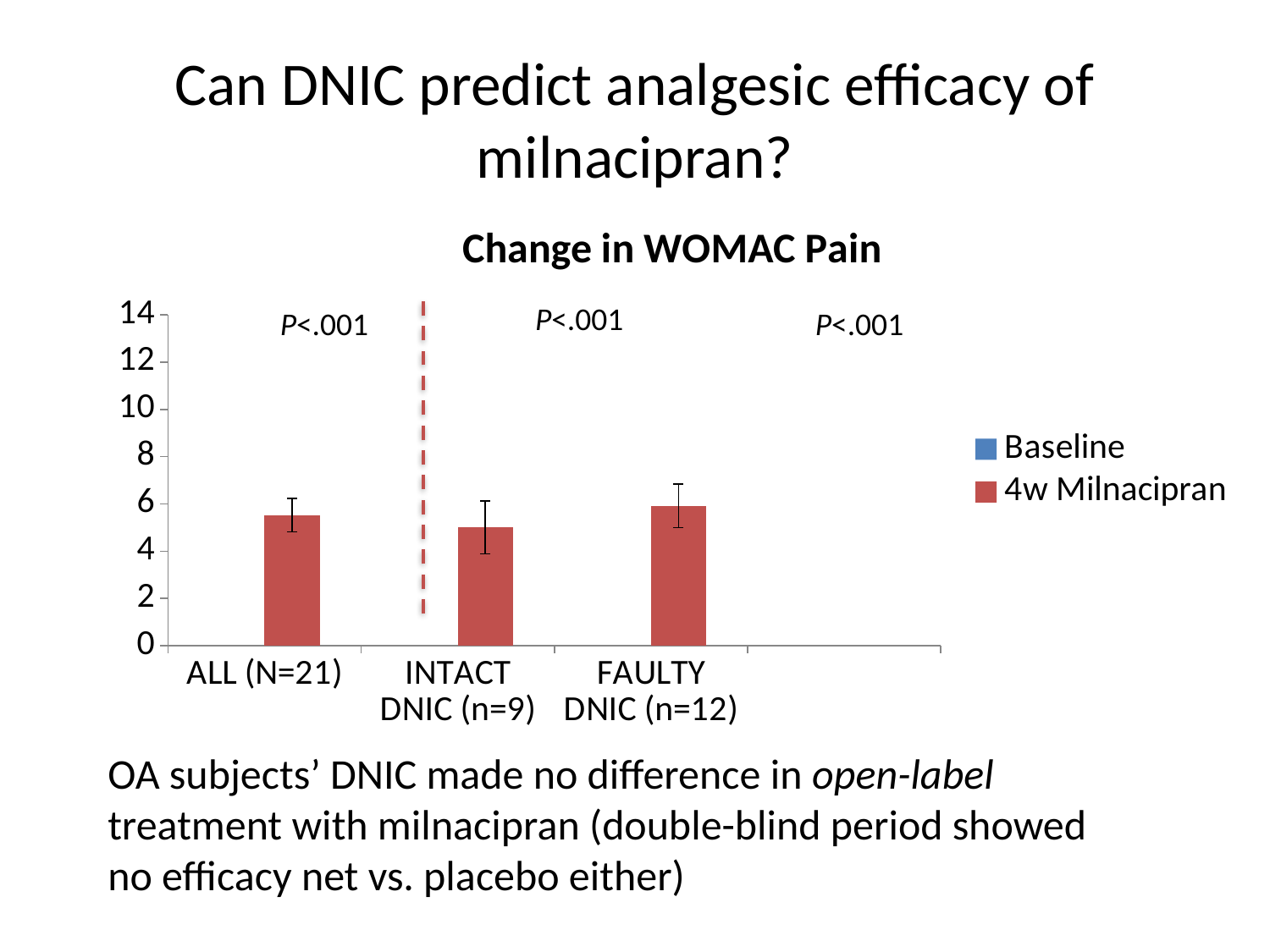
Is the 4w Milnacipran value for FAULTY DNIC (n=12) greater or less than 4? greater How many series does the chart legend list? 2 What is the highest value shown on the y axis of the chart? 14 Which has the larger 4w Milnacipran bar, INTACT DNIC (n=9) or FAULTY DNIC (n=12)? FAULTY DNIC (n=12) Is the 4w Milnacipran value for ALL (N=21) greater or less than 4? greater Is the 4w Milnacipran value for ALL (N=21) greater or less than 10? less What are the two series named in the chart legend? Baseline and 4w Milnacipran What kind of chart is shown on the slide? bar chart How many labelled categories are shown on the x axis of the chart? 3 What is the title of the chart? Change in WOMAC Pain